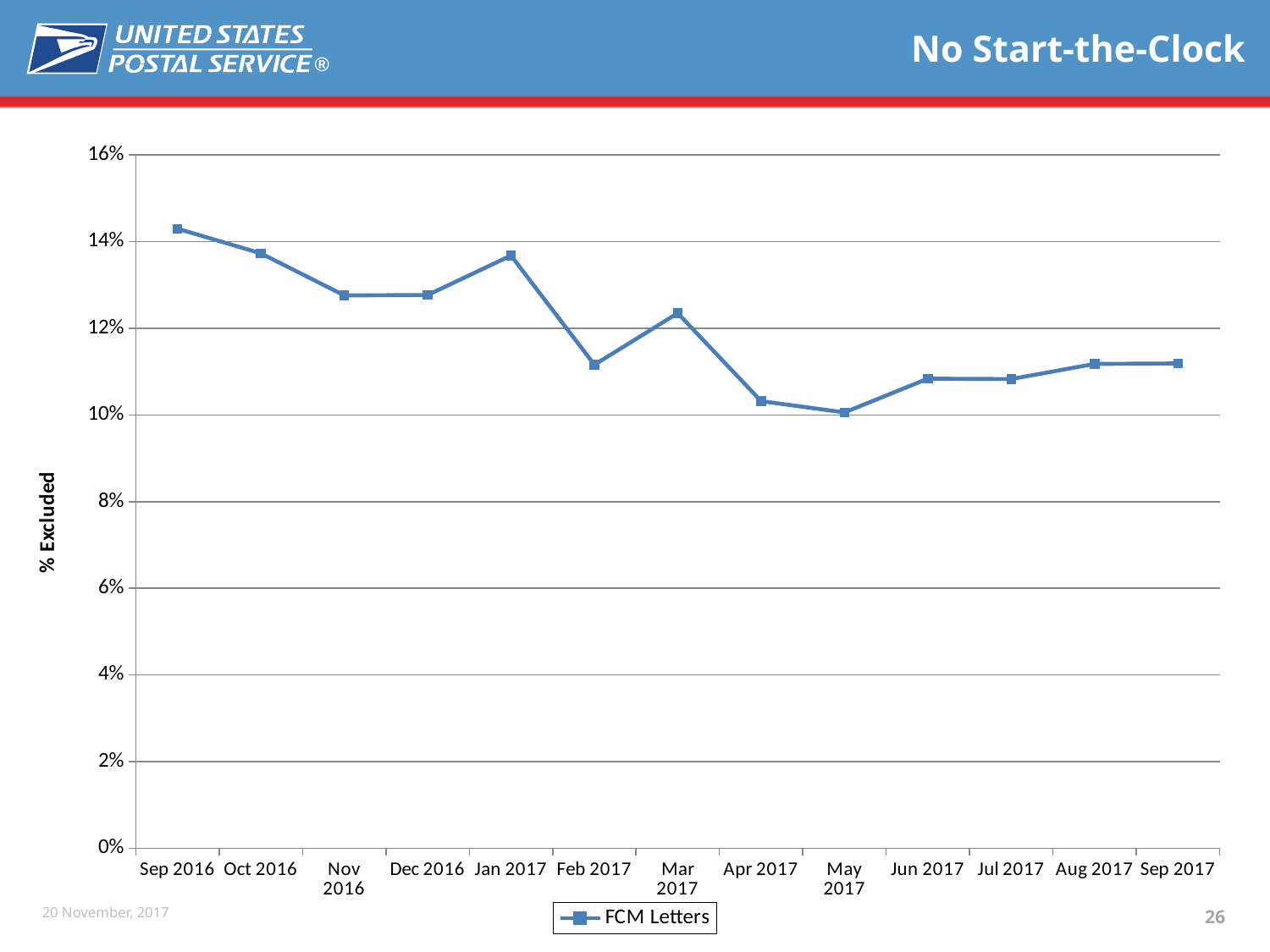
How many months are plotted on the x axis? 13 Is the value for Feb 2017 greater or less than 12%? less Which month has the lowest value for FCM Letters? May 2017 What is the name of the series shown in the legend? FCM Letters Is the value for Sep 2016 greater or less than 14%? greater How many series does the legend list? 1 Which month has the highest value for FCM Letters? Sep 2016 Which is larger, the value for Feb 2017 or the value for Mar 2017? Mar 2017 What kind of chart is shown on the slide? line chart Overall, does the FCM Letters line rise or fall from Sep 2016 to Sep 2017? fall What is the label on the vertical axis? % Excluded Is the value for Apr 2017 greater or less than 10%? greater